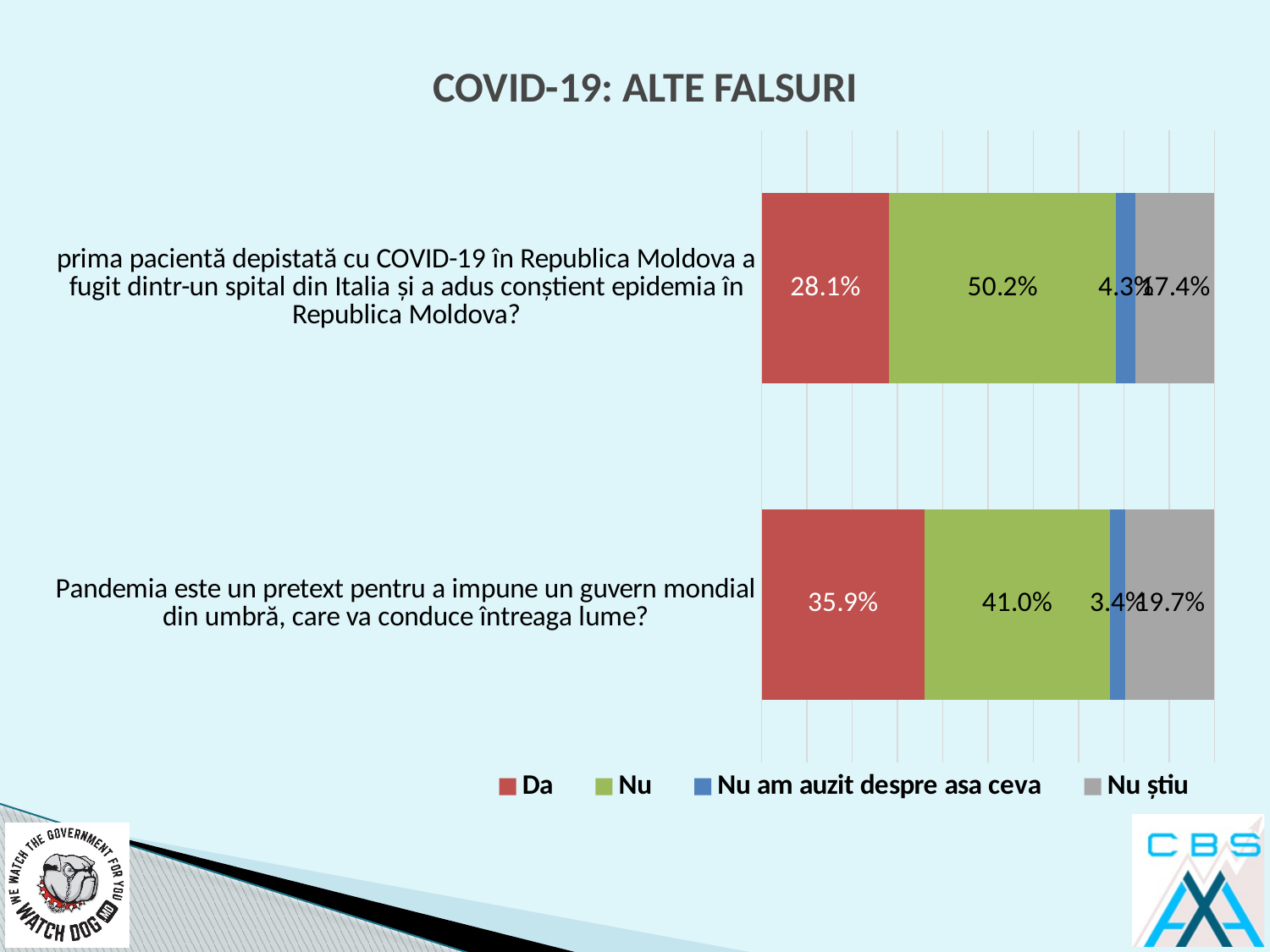
What is the 'Da' value for the question about the pandemic being a pretext for a world government? 35.9% Which question has the higher 'Da' value: the one about the first COVID-19 patient from Italy or the one about the pandemic as a pretext for a world government? Pandemia este un pretext pentru a impune un guvern mondial din umbră, care va conduce întreaga lume? Which response has the smallest share for the question about the pandemic being a pretext for a world government? Nu am auzit despre asa ceva How many categories (questions) are plotted in the chart? 2 What is the title of the chart? COVID-19: ALTE FALSURI What is the 'Nu am auzit despre asa ceva' value for the question about the first COVID-19 patient who fled a hospital in Italy? 4.3% What is the 'Nu' value for the question about the first COVID-19 patient who fled a hospital in Italy? 50.2% What is the 'Nu știu' value for the question about the pandemic being a pretext for a world government? 19.7% What is the difference between the 'Nu' and 'Da' values for the question about the pandemic being a pretext for a world government? 5.1% How many series does the legend list? 4 Which response has the largest share for the question about the first COVID-19 patient who fled a hospital in Italy? Nu What kind of chart is shown on the slide? stacked bar chart